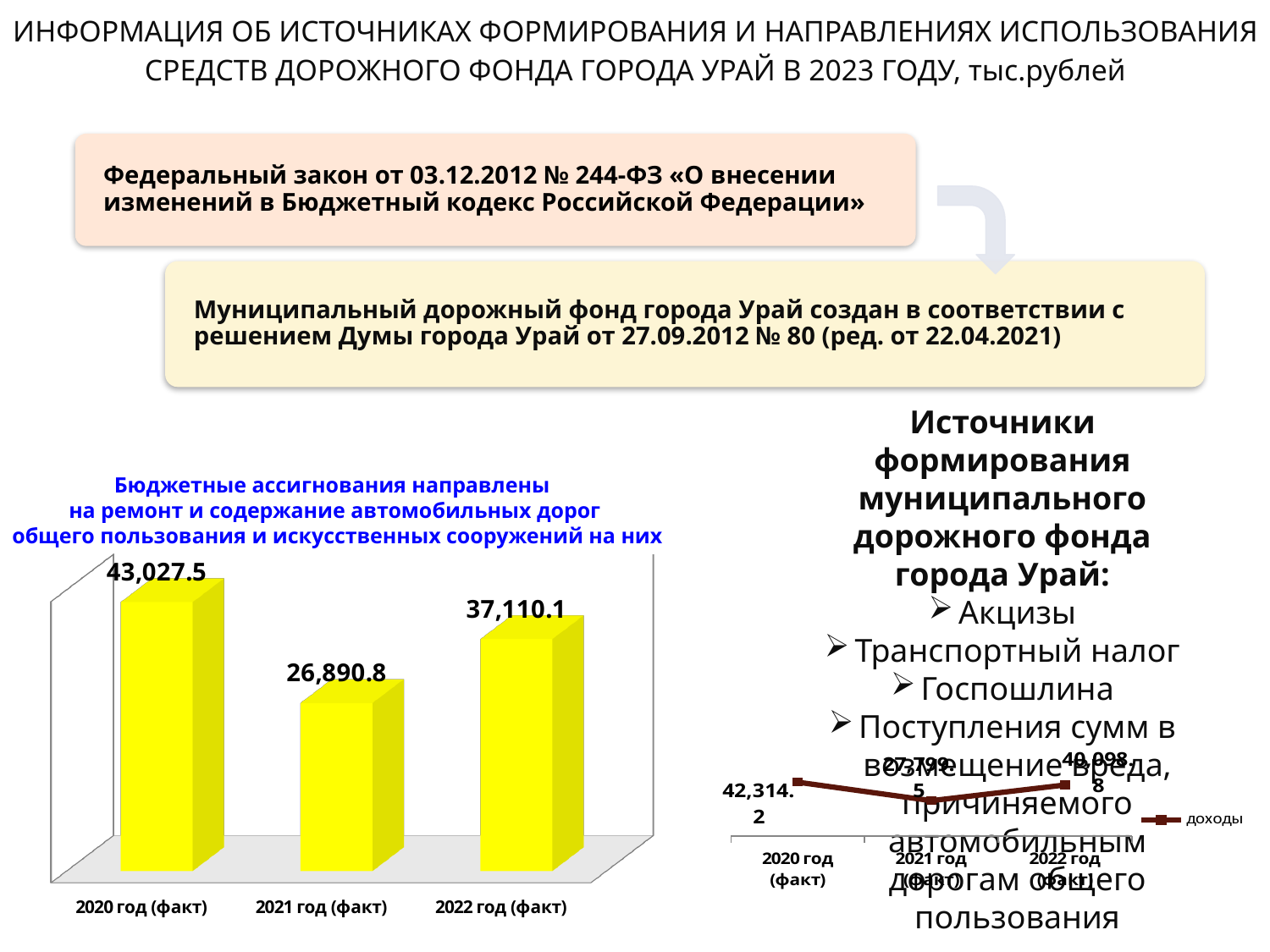
In the bar chart on the left, which is larger: the value for 2020 год (факт) or 2022 год (факт)? 2020 год (факт) In the bar chart on the left, which year has the highest value? 2020 год (факт) In the bar chart on the left, what is the value for 2021 год (факт)? 26,890.8 What series name does the legend of the line chart at the bottom right show? доходы What type of chart is shown on the left of the slide? Bar chart In the bar chart on the left, what is the difference between the values for 2022 год (факт) and 2021 год (факт)? 10,219.3 In the bar chart on the left, what is the value for 2022 год (факт)? 37,110.1 In the bar chart on the left, which year has the lowest value? 2021 год (факт) How many bars are shown in the bar chart on the left? 3 What type of chart is shown at the bottom right of the slide? Line chart In the bar chart on the left, what is the value for 2020 год (факт)? 43,027.5 In the bar chart on the left, what is the difference between the values for 2020 год (факт) and 2021 год (факт)? 16,136.7